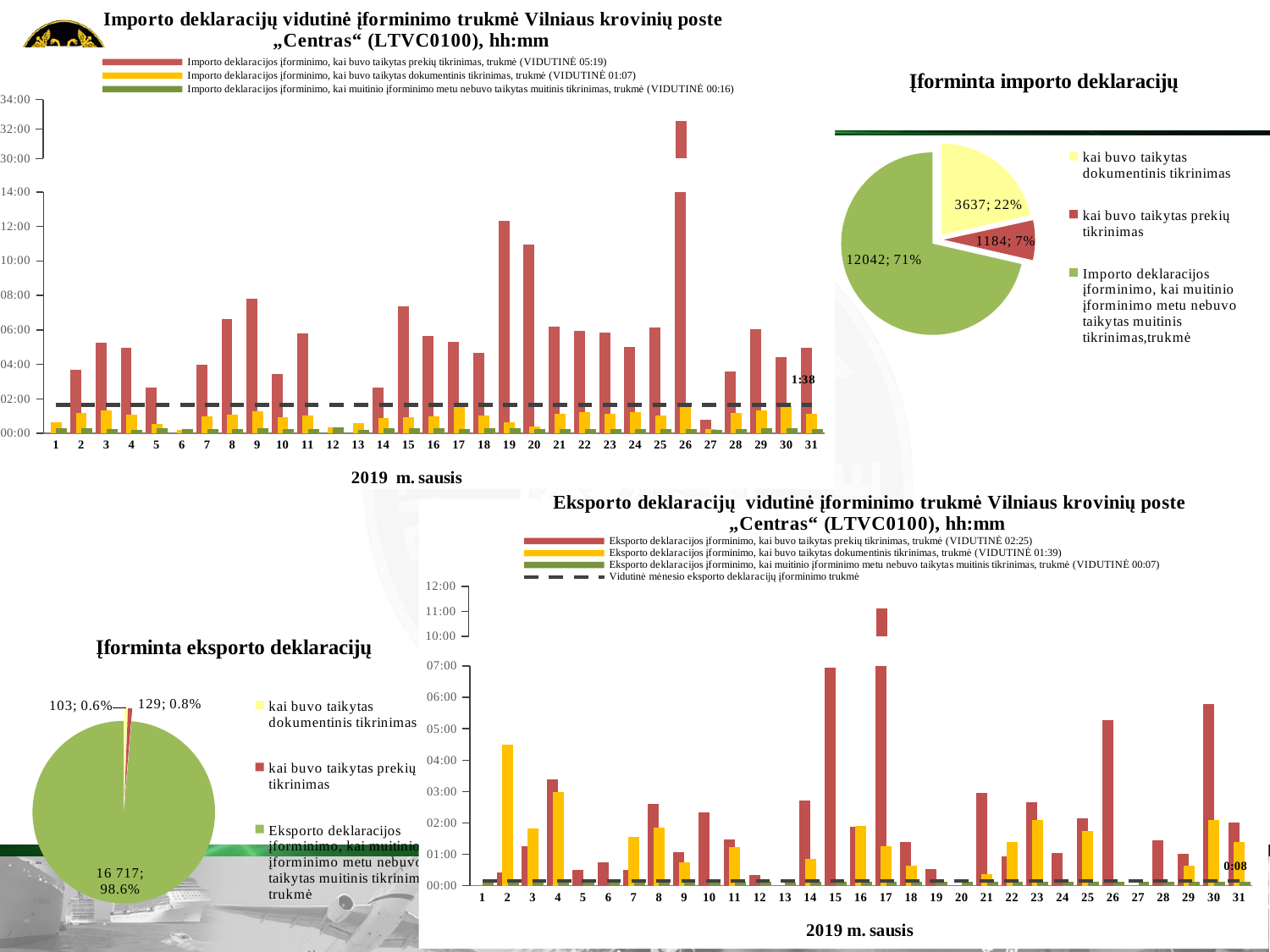
In the top-left bar chart (Importo deklaracijų vidutinė įforminimo trukmė), on which day of the month is the red bar (prekių tikrinimas) the highest? 26 In the bottom-right bar chart (Eksporto deklaracijų vidutinė įforminimo trukmė), on which day is the red bar (prekių tikrinimas) the highest? 17 In the top-left bar chart (Importo deklaracijų vidutinė įforminimo trukmė), is the red bar for day 19 greater or less than 10:00? greater How many days (categories) are shown on the x axis of the bottom-right bar chart (Eksporto deklaracijų vidutinė įforminimo trukmė)? 31 In the pie chart titled "Įforminta eksporto deklaracijų", which slice is the largest? Eksporto deklaracijos įforminimo, kai muitinio įforminimo metu nebuvo taikytas muitinis tikrinimas, trukmė In the pie chart titled "Įforminta importo deklaracijų", which slice is the smallest? kai buvo taikytas prekių tikrinimas In the pie chart titled "Įforminta eksporto deklaracijų", which is larger: the count for "kai buvo taikytas dokumentinis tikrinimas" or the count for "kai buvo taikytas prekių tikrinimas"? kai buvo taikytas prekių tikrinimas In the pie chart titled "Įforminta importo deklaracijų", what is the difference between the count for "kai buvo taikytas dokumentinis tikrinimas" and the count for "kai buvo taikytas prekių tikrinimas"? 2453 How many entries does the legend of the bottom-right chart (Eksporto deklaracijų vidutinė įforminimo trukmė) list? 4 In the pie chart titled "Įforminta eksporto deklaracijų", what value is shown for the slice "kai buvo taikytas prekių tikrinimas"? 129; 0.8% In the pie chart titled "Įforminta importo deklaracijų", what share of the pie is the slice for declarations where no customs check was applied ("nebuvo taikytas muitinis tikrinimas")? 71% In the pie chart titled "Įforminta importo deklaracijų", what value is shown for the slice "kai buvo taikytas dokumentinis tikrinimas"? 3637; 22%